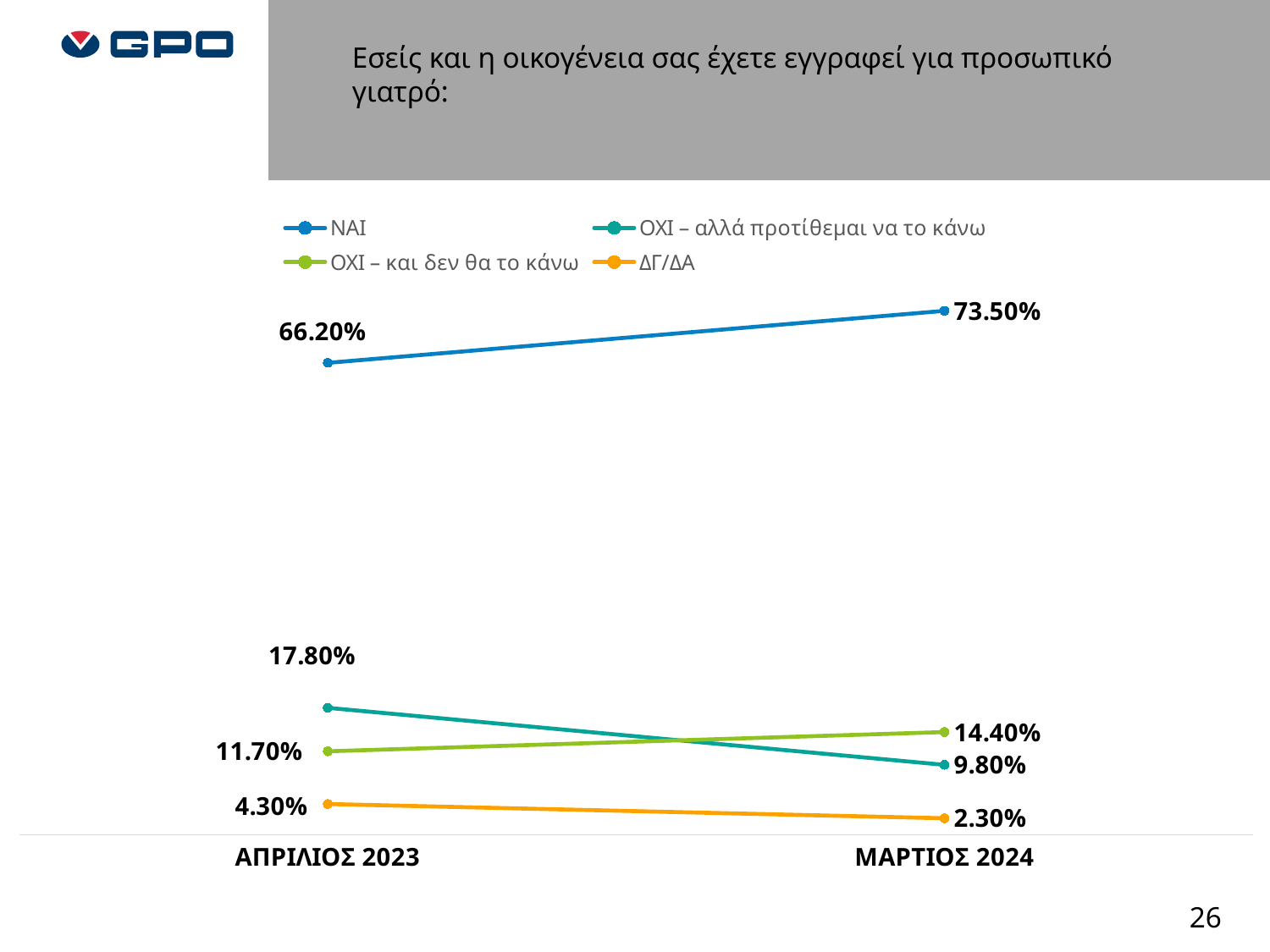
In ΜΑΡΤΙΟΣ 2024, which is larger: ΟΧΙ – και δεν θα το κάνω or ΟΧΙ – αλλά προτίθεμαι να το κάνω? ΟΧΙ – και δεν θα το κάνω What kind of chart is shown on the slide? line chart By how much did the value for ΝΑΙ change from ΑΠΡΙΛΙΟΣ 2023 to ΜΑΡΤΙΟΣ 2024? 7.30% Which series has the lowest value in ΑΠΡΙΛΙΟΣ 2023? ΔΓ/ΔΑ What is the value for ΟΧΙ – αλλά προτίθεμαι να το κάνω in ΑΠΡΙΛΙΟΣ 2023? 17.80% Which series has the highest value in ΜΑΡΤΙΟΣ 2024? ΝΑΙ What is the value for ΝΑΙ in ΑΠΡΙΛΙΟΣ 2023? 66.20% What is the value for ΔΓ/ΔΑ in ΜΑΡΤΙΟΣ 2024? 2.30% Does the value for ΟΧΙ – αλλά προτίθεμαι να το κάνω rise or fall from ΑΠΡΙΛΙΟΣ 2023 to ΜΑΡΤΙΟΣ 2024? fall What is the value for ΝΑΙ in ΜΑΡΤΙΟΣ 2024? 73.50% How many series does the legend list? 4 How many time points are shown on the x axis? 2